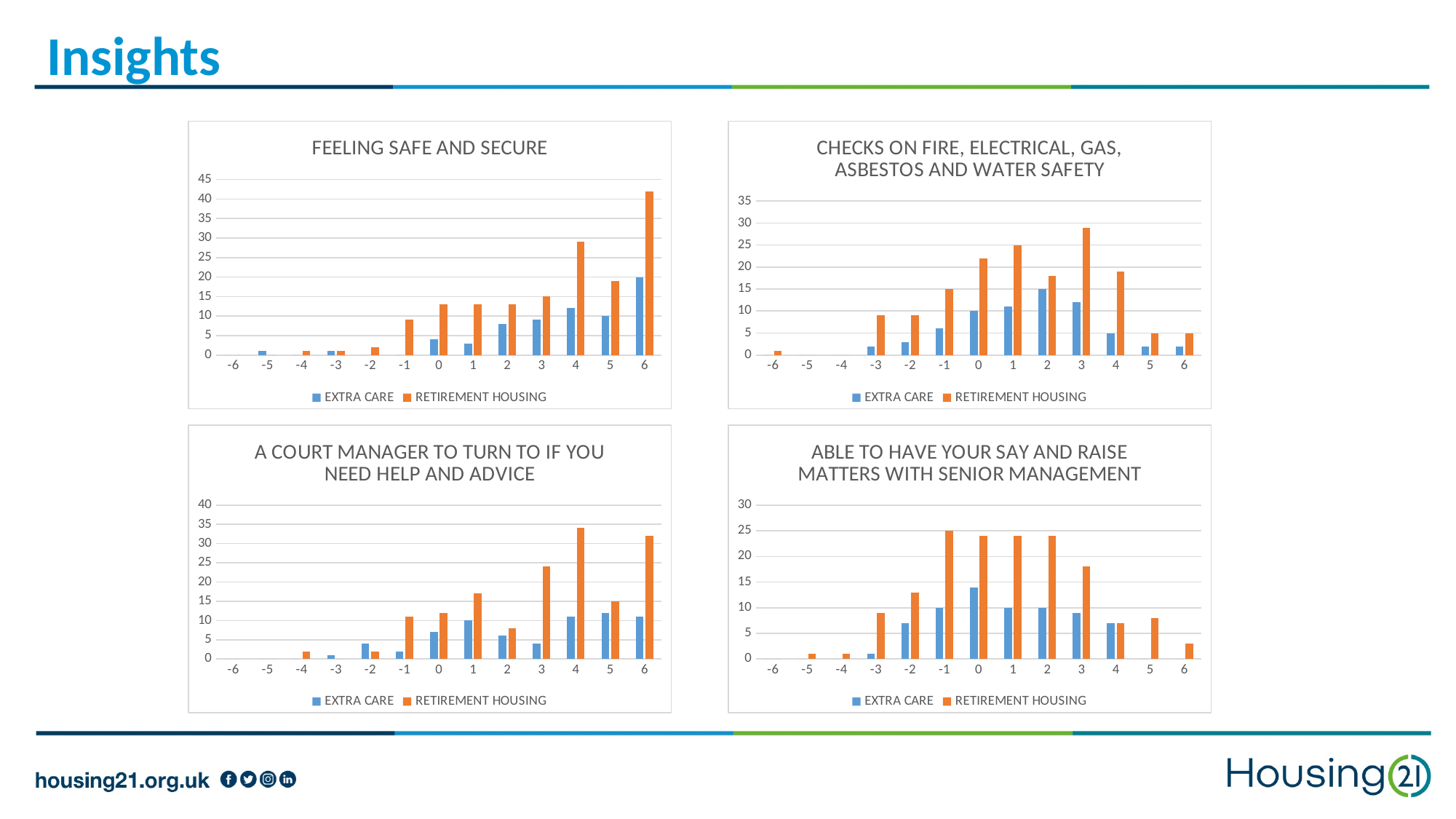
In the "FEELING SAFE AND SECURE" chart, which category has the highest RETIREMENT HOUSING value? 6 In the "A COURT MANAGER TO TURN TO IF YOU NEED HELP AND ADVICE" chart, is the RETIREMENT HOUSING value for category 4 greater or less than 30? greater In the "FEELING SAFE AND SECURE" chart, is the RETIREMENT HOUSING value for category 6 greater or less than 40? greater What kind of chart is "FEELING SAFE AND SECURE"? Bar chart What are the two legend entries in the "ABLE TO HAVE YOUR SAY AND RAISE MATTERS WITH SENIOR MANAGEMENT" chart? EXTRA CARE and RETIREMENT HOUSING In the "ABLE TO HAVE YOUR SAY AND RAISE MATTERS WITH SENIOR MANAGEMENT" chart, which category has the highest EXTRA CARE value? 0 How many series does the legend of the "FEELING SAFE AND SECURE" chart list? 2 How many categories are shown on the x axis of the "A COURT MANAGER TO TURN TO IF YOU NEED HELP AND ADVICE" chart? 13 In the "CHECKS ON FIRE, ELECTRICAL, GAS, ASBESTOS AND WATER SAFETY" chart, is the EXTRA CARE value for category 2 greater or less than 10? greater In the "CHECKS ON FIRE, ELECTRICAL, GAS, ASBESTOS AND WATER SAFETY" chart, which category has the highest RETIREMENT HOUSING value? 3 In the "FEELING SAFE AND SECURE" chart, which series has the larger value for category 4, EXTRA CARE or RETIREMENT HOUSING? RETIREMENT HOUSING